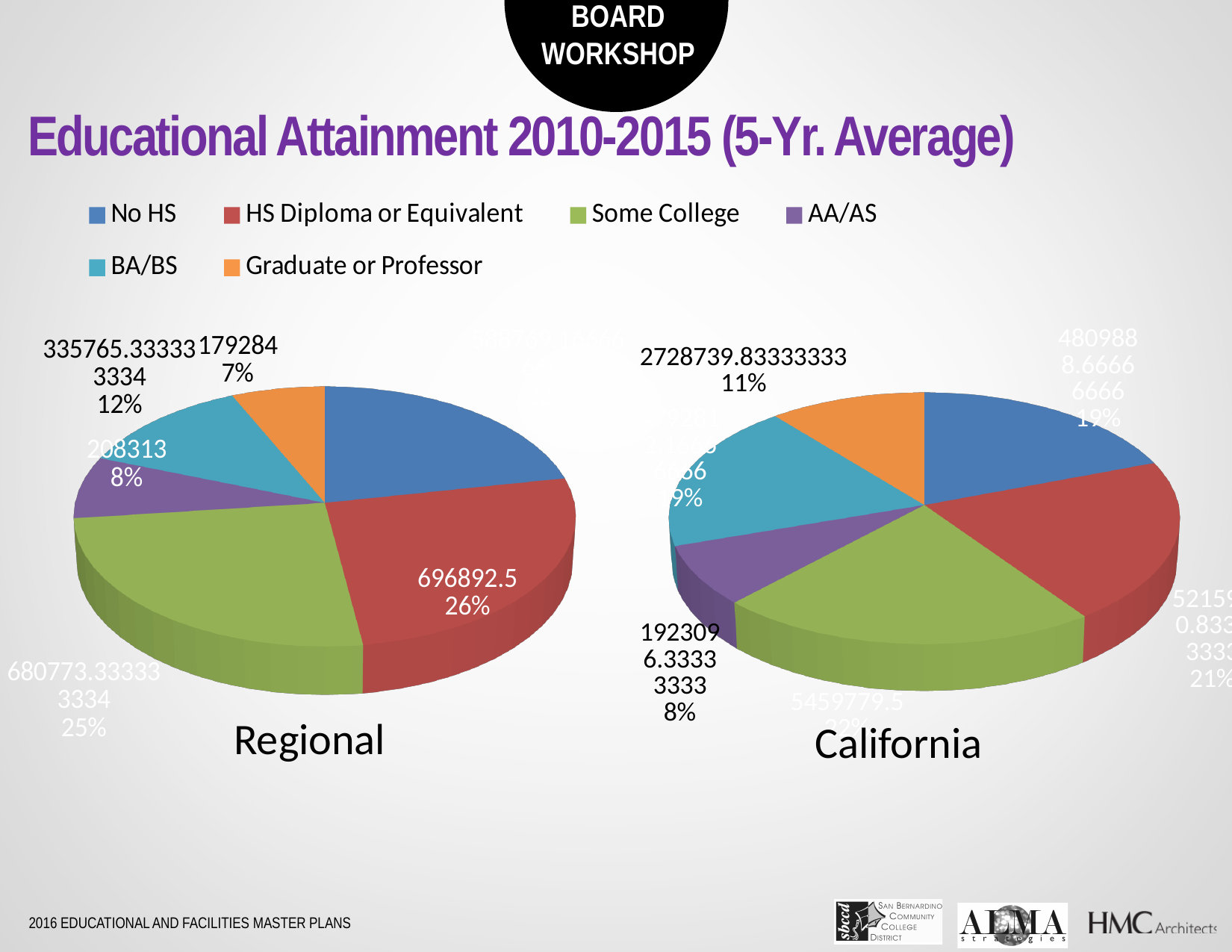
In the Regional pie chart, what is the value for Graduate or Professor? 179284 In the Regional pie chart, what is the value for AA/AS? 208313 In the California pie chart, what percentage share does AA/AS have? 8% In the Regional pie chart, what is the value for HS Diploma or Equivalent? 696892.5 How many categories does the legend list? 6 In the Regional pie chart, which is larger: HS Diploma or Equivalent or Graduate or Professor? HS Diploma or Equivalent In the Regional pie chart, what percentage share does BA/BS have? 12% In the California pie chart, what percentage share does Graduate or Professor have? 11% Which colour represents Some College in the legend? Green In the Regional pie chart, what is the difference in percentage points between HS Diploma or Equivalent (26%) and Graduate or Professor (7%)? 19 What type of charts are shown on the slide? Pie charts